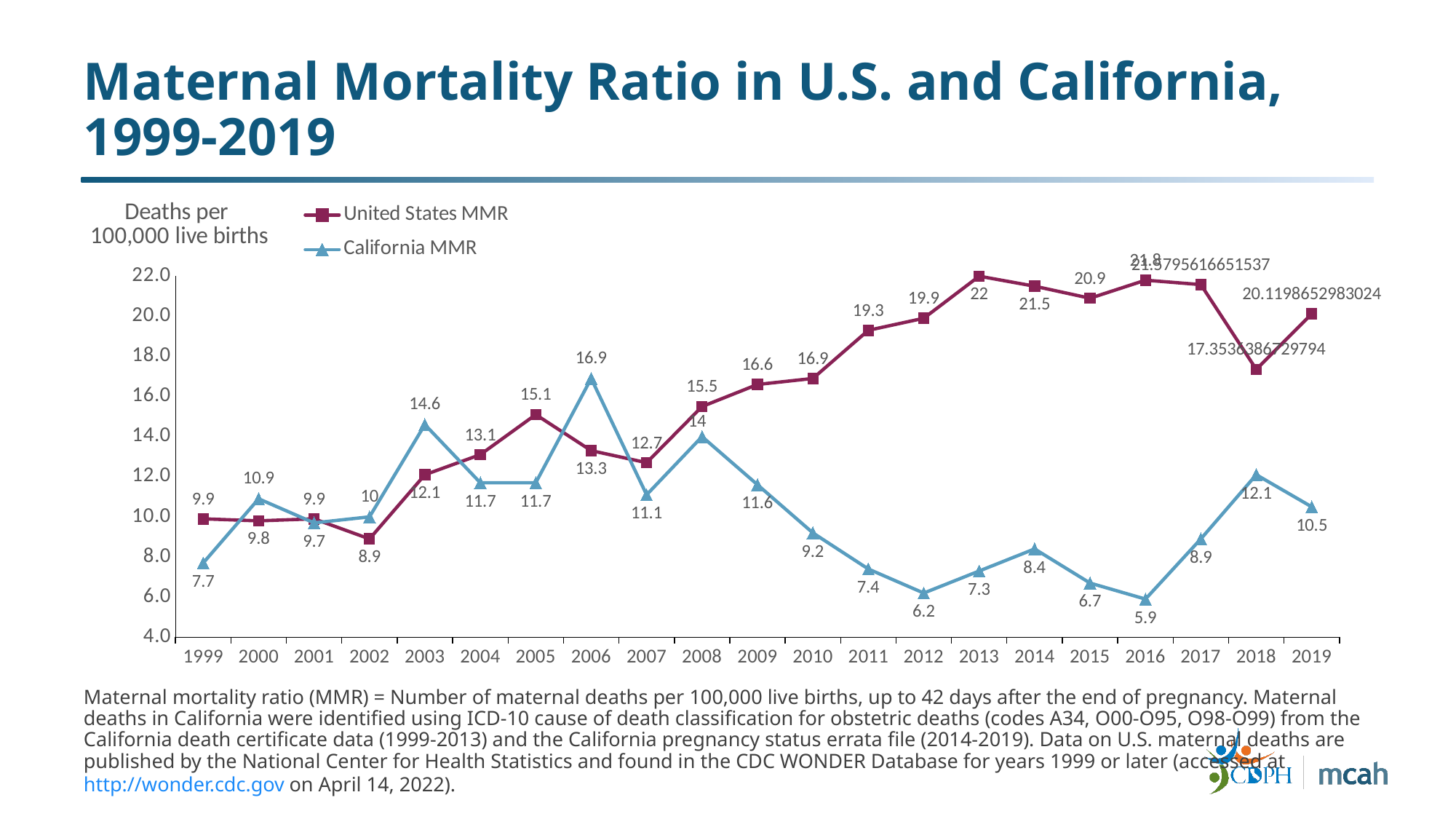
In 2006, how much higher is the California MMR than the United States MMR? 3.6 In which year is the United States MMR highest? 2013 What is the United States MMR value for 2002? 8.9 How many years are shown on the x axis? 21 How many series does the legend list? 2 In 2003, which series has the higher value, United States MMR or California MMR? California MMR In which year is the California MMR highest? 2006 What is the United States MMR value for 2013? 22 What is the California MMR value for 2016? 5.9 What kind of chart is shown on the slide? Line chart In which year is the California MMR lowest? 2016 Does the California MMR rise or fall from 2006 to 2012? Fall